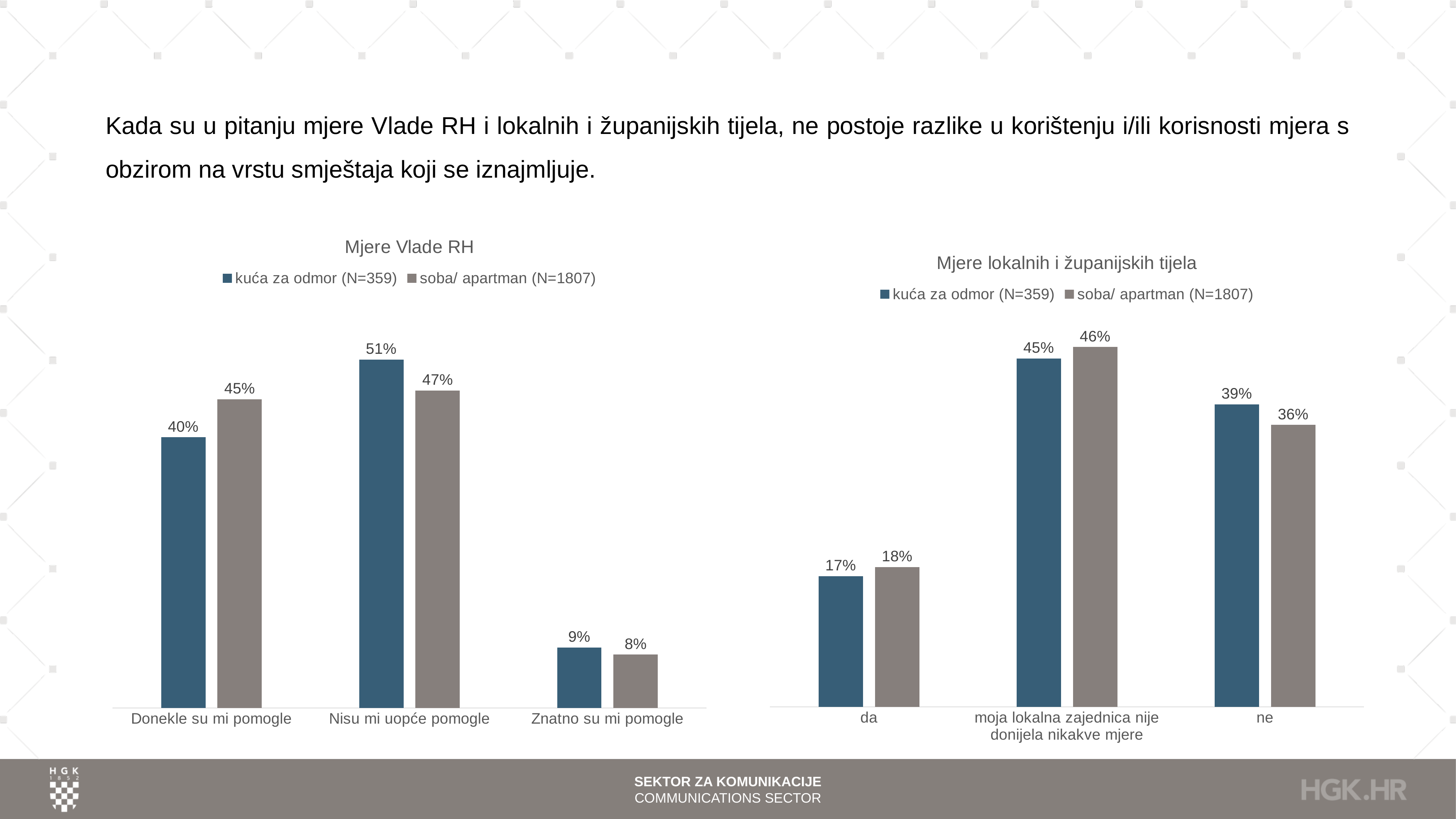
How many series does the legend of the 'Mjere Vlade RH' chart list? 2 In the 'Mjere lokalnih i županijskih tijela' chart, what is the value for 'soba/ apartman (N=1807)' in the 'ne' category? 36% In the 'Mjere Vlade RH' chart, which series has the larger value in the 'Nisu mi uopće pomogle' category? kuća za odmor (N=359) In the 'Mjere lokalnih i županijskih tijela' chart, what is the value for 'kuća za odmor (N=359)' in the 'da' category? 17% In the 'Mjere Vlade RH' chart, which category has the lowest value for 'kuća za odmor (N=359)'? Znatno su mi pomogle In the 'Mjere lokalnih i županijskih tijela' chart, which category has the highest value for 'soba/ apartman (N=1807)'? moja lokalna zajednica nije donijela nikakve mjere In the 'Mjere Vlade RH' chart, what is the value for 'kuća za odmor (N=359)' in the 'Nisu mi uopće pomogle' category? 51% What kind of chart is the 'Mjere Vlade RH' chart? Bar chart How many categories are shown on the x axis of the 'Mjere lokalnih i županijskih tijela' chart? 3 In the 'Mjere lokalnih i županijskih tijela' chart, what is the difference between the 'kuća za odmor (N=359)' and 'soba/ apartman (N=1807)' values in the 'ne' category? 3% In the 'Mjere Vlade RH' chart, what is the difference between the 'kuća za odmor (N=359)' and 'soba/ apartman (N=1807)' values in the 'Donekle su mi pomogle' category? 5% In the 'Mjere Vlade RH' chart, what is the value for 'soba/ apartman (N=1807)' in the 'Donekle su mi pomogle' category? 45%